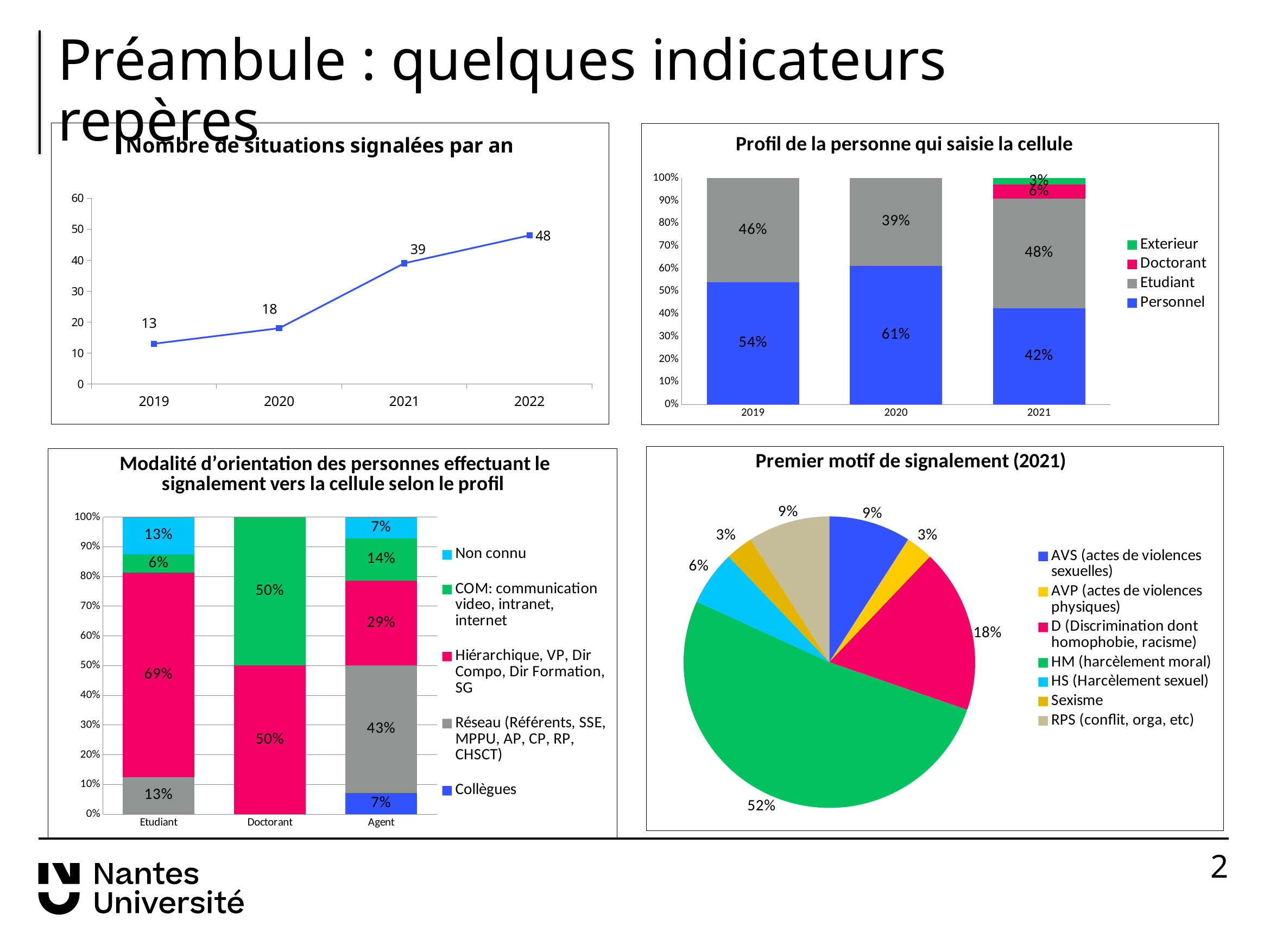
In the chart 'Nombre de situations signalées par an', what is the value for 2021? 39 In the pie chart 'Premier motif de signalement (2021)', what share does HM (harcèlement moral) have? 52% In the chart 'Profil de la personne qui saisie la cellule', how many series does the legend list? 4 In the chart 'Profil de la personne qui saisie la cellule', what is the Personnel share for 2020? 61% In the chart 'Modalité d'orientation des personnes effectuant le signalement vers la cellule selon le profil', what is the Réseau share for Agent? 43% In the chart 'Nombre de situations signalées par an', do the values rise or fall from 2019 to 2022? rise In the pie chart 'Premier motif de signalement (2021)', how many slices are there? 7 What kind of chart is 'Nombre de situations signalées par an'? line chart In the chart 'Modalité d'orientation des personnes effectuant le signalement vers la cellule selon le profil', how many profile categories are shown on the x axis? 3 In the chart 'Profil de la personne qui saisie la cellule', which is larger for 2021, Personnel or Etudiant? Etudiant In the chart 'Nombre de situations signalées par an', what is the difference between the values for 2022 and 2019? 35 In the chart 'Nombre de situations signalées par an', which year has the highest value? 2022